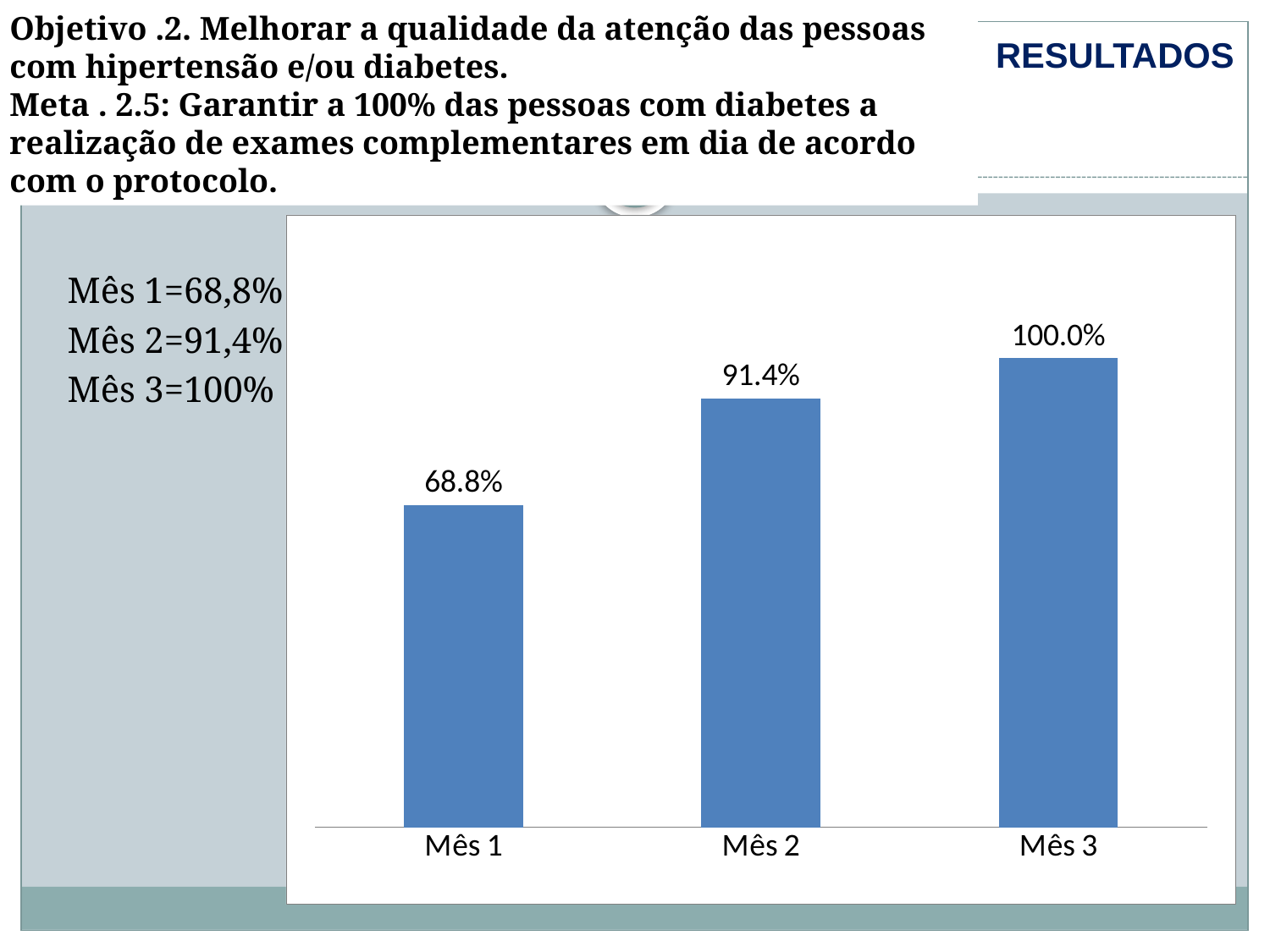
What is the difference between the values for Mês 3 and Mês 1? 31.2% What is the difference between the values for Mês 2 and Mês 1? 22.6% What colour are the bars in the chart? Blue Do the values rise or fall from Mês 1 to Mês 3? Rise Which is larger, the value for Mês 1 or the value for Mês 2? Mês 2 What is the value for Mês 1? 68.8% What is the value for Mês 2? 91.4% Which month has the highest value? Mês 3 What kind of chart is shown on the slide? Bar chart How many categories are shown on the x axis? 3 What is the value for Mês 3? 100.0% Which month has the lowest value? Mês 1